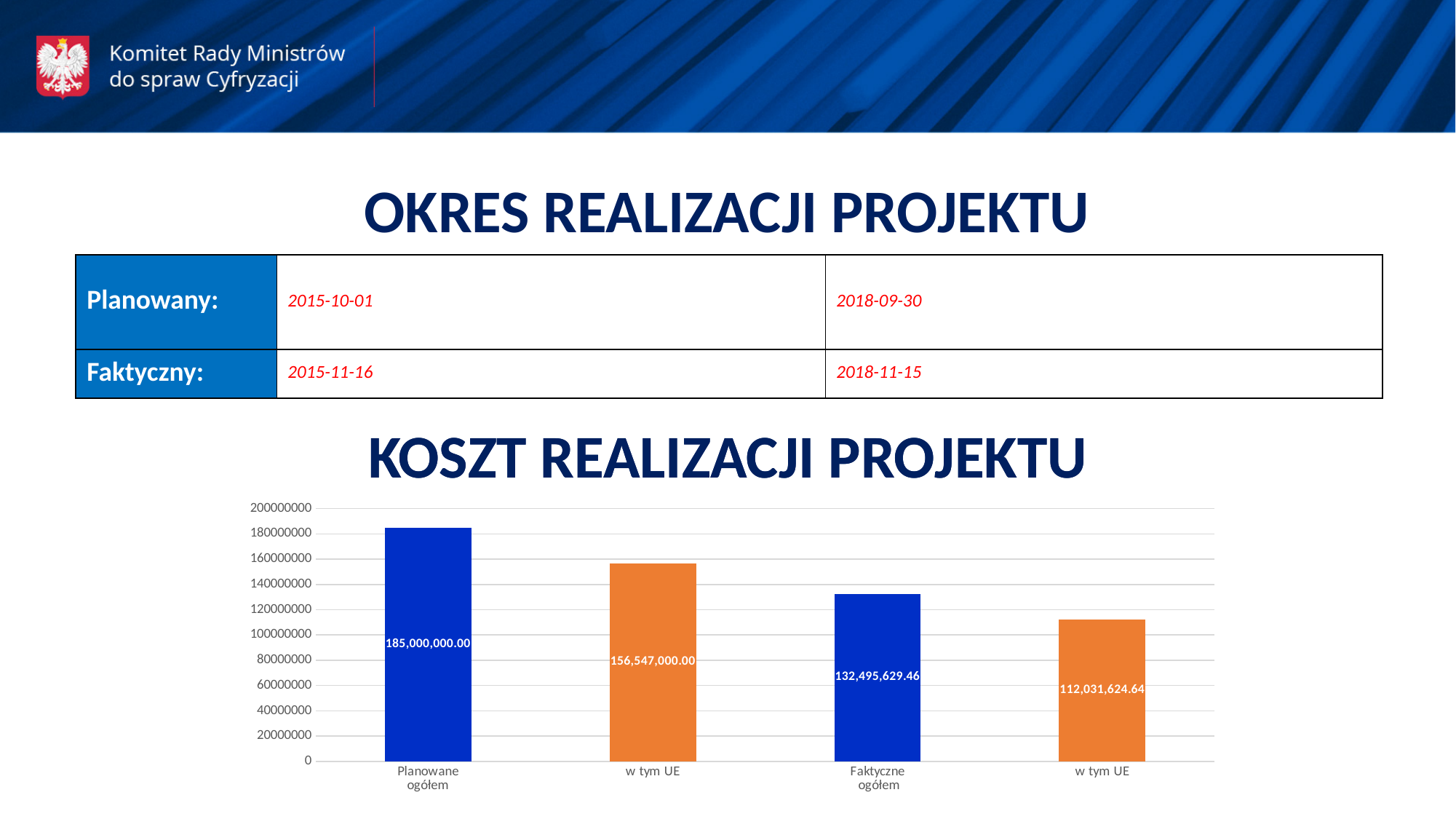
How many bars are plotted in the KOSZT REALIZACJI PROJEKTU chart? 4 What is the value of the Planowane ogółem bar in the KOSZT REALIZACJI PROJEKTU chart? 185,000,000.00 In the KOSZT REALIZACJI PROJEKTU chart, what is the difference between Planowane ogółem and its 'w tym UE' bar (the second bar)? 28,453,000.00 In the KOSZT REALIZACJI PROJEKTU chart, which is larger: Faktyczne ogółem or the 'w tym UE' bar after Planowane ogółem? w tym UE (after Planowane ogółem) Which bar in the KOSZT REALIZACJI PROJEKTU chart has the highest value? Planowane ogółem In the KOSZT REALIZACJI PROJEKTU chart, what is the value of the Faktyczne ogółem bar? 132,495,629.46 Which bar in the KOSZT REALIZACJI PROJEKTU chart has the lowest value? w tym UE (the fourth bar, after Faktyczne ogółem) In the KOSZT REALIZACJI PROJEKTU chart, what is the value of the 'w tym UE' bar that follows Faktyczne ogółem (the fourth bar)? 112,031,624.64 In the KOSZT REALIZACJI PROJEKTU chart, is the value for Faktyczne ogółem greater or less than 120000000? greater What type of chart is shown under the heading KOSZT REALIZACJI PROJEKTU? bar chart In the KOSZT REALIZACJI PROJEKTU chart, what is the difference between Planowane ogółem and Faktyczne ogółem? 52,504,370.54 In the KOSZT REALIZACJI PROJEKTU chart, what is the value of the 'w tym UE' bar that follows Planowane ogółem (the second bar)? 156,547,000.00